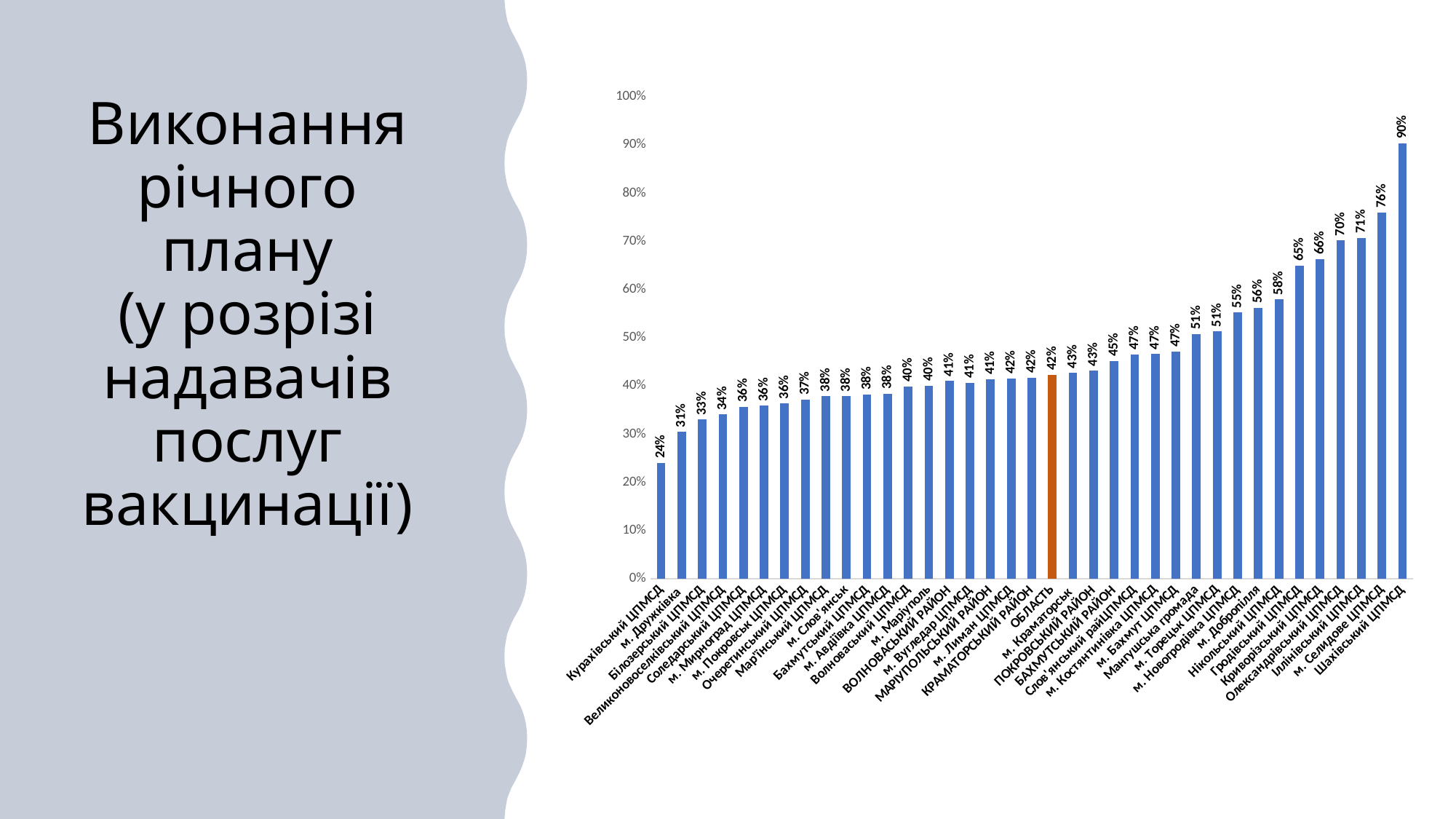
Which bar is coloured orange instead of blue? ОБЛАСТЬ What is the value for Курахівський ЦПМСД? 24% What is the value for ОБЛАСТЬ? 42% What is the value for м. Селидове ЦПМСД? 76% What is the value for Шахівський ЦПМСД? 90% Which category has the lowest value? Курахівський ЦПМСД How many bars are plotted in the chart? 37 What kind of chart is shown on the slide? bar chart What is the difference between the values for Шахівський ЦПМСД and Курахівський ЦПМСД? 66% Is the value for Іллінівський ЦПМСД greater or less than 60%? greater Which category has the highest value? Шахівський ЦПМСД